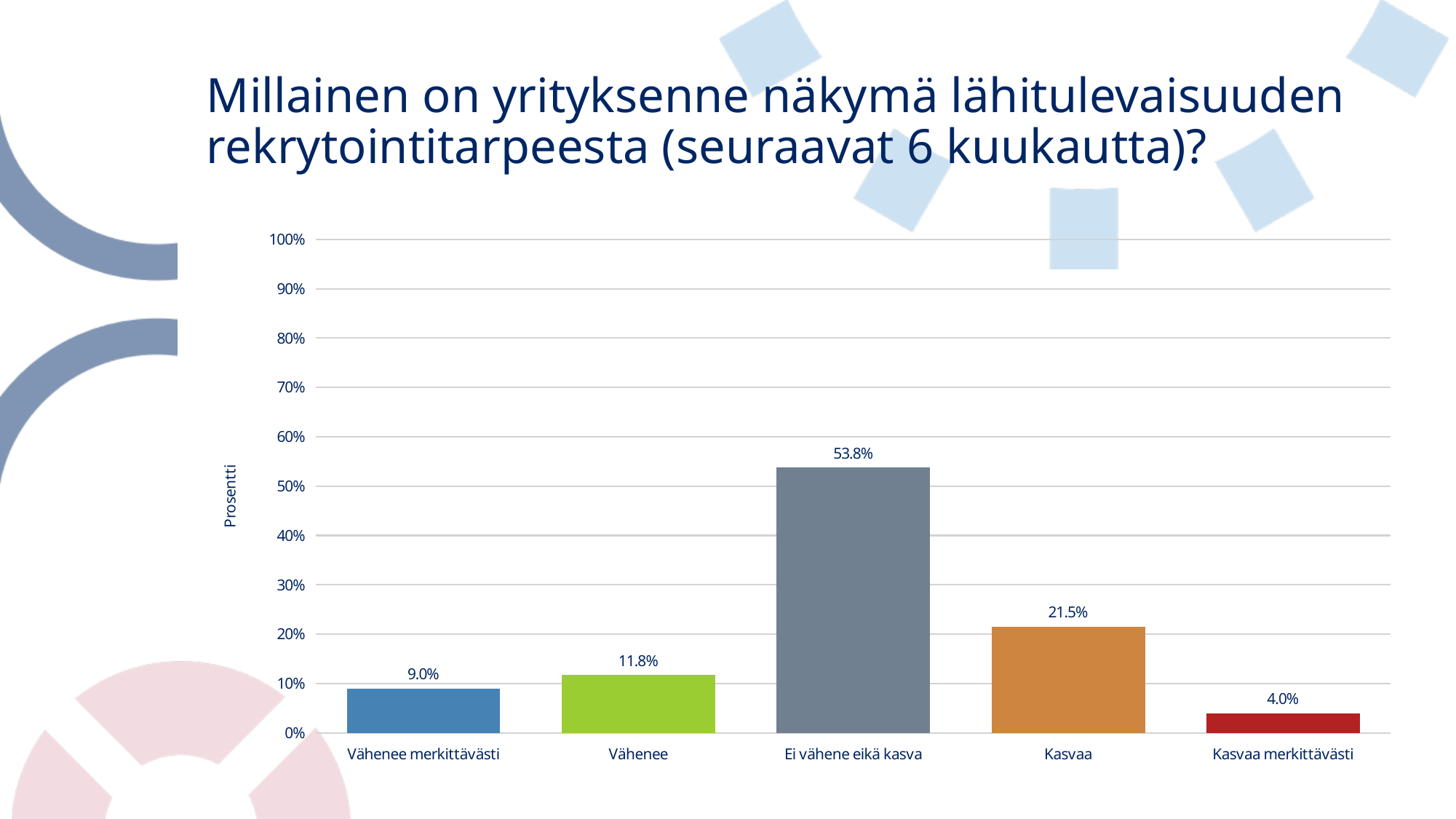
What is the value for "Kasvaa merkittävästi"? 4.0% Is the value for "Ei vähene eikä kasva" greater or less than 50%? greater How many categories are shown on the x axis? 5 Which category has the lowest value? Kasvaa merkittävästi What kind of chart is shown on the slide? bar chart What is the value for "Ei vähene eikä kasva"? 53.8% What is the label of the y axis? Prosentti Which is larger, the value for "Vähenee" or the value for "Vähenee merkittävästi"? Vähenee Which category has the highest value? Ei vähene eikä kasva What is the value for "Kasvaa"? 21.5% What is the difference between the values for "Kasvaa" and "Vähenee"? 9.7% What is the value for "Vähenee merkittävästi"? 9.0%